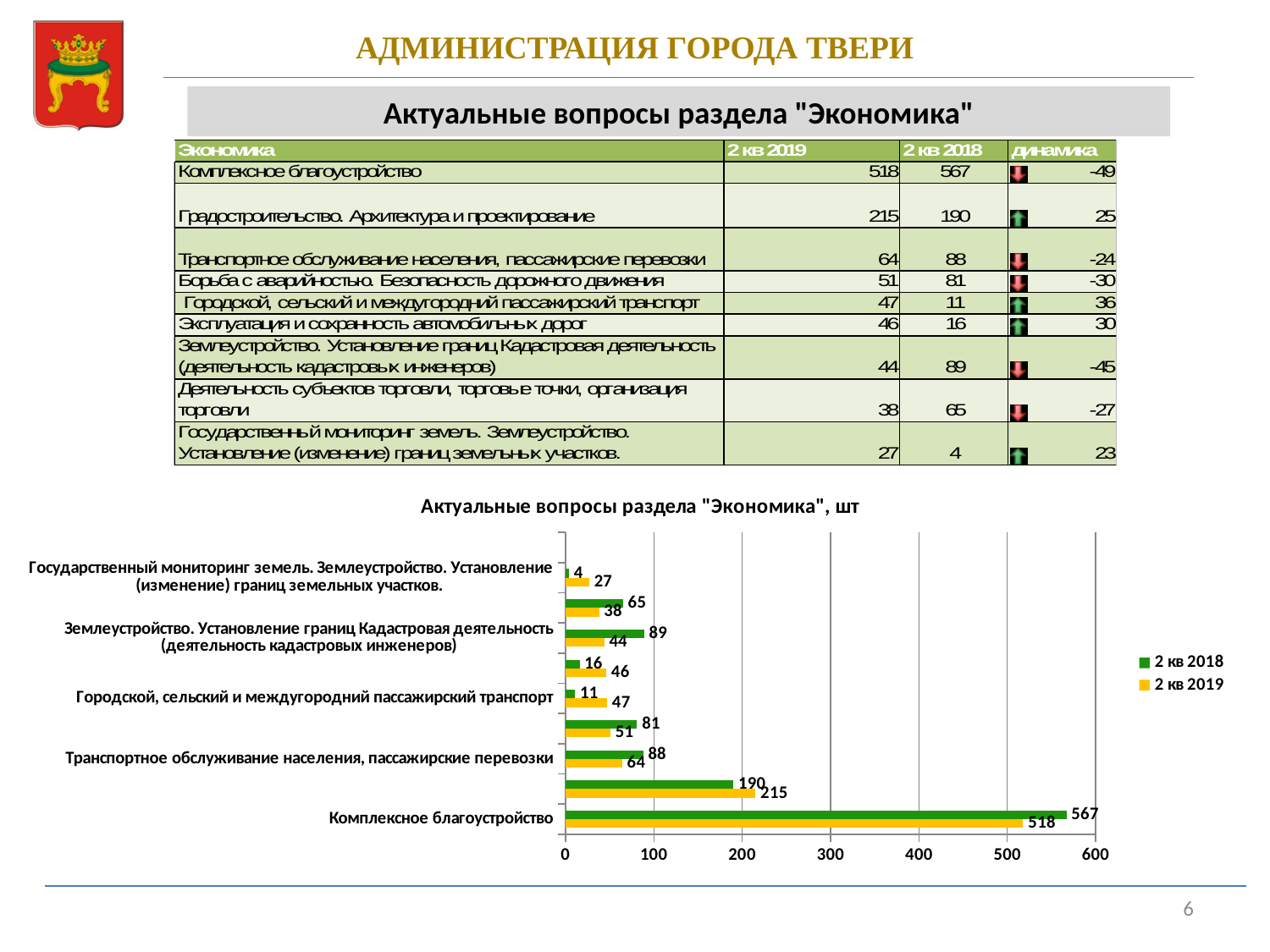
What are the two series named in the chart legend? 2 кв 2018 and 2 кв 2019 What is the 2 кв 2019 value for Комплексное благоустройство in the chart? 518 What kind of chart is shown on the slide? bar chart What is the 2 кв 2018 value for Государственный мониторинг земель. Землеустройство. Установление (изменение) границ земельных участков. in the chart? 4 Is the 2 кв 2018 value for Комплексное благоустройство greater or less than 500? greater Which category has the lowest 2 кв 2018 value in the chart? Государственный мониторинг земель. Землеустройство. Установление (изменение) границ земельных участков. What is the 2 кв 2019 value for Землеустройство. Установление границ Кадастровая деятельность (деятельность кадастровых инженеров) in the chart? 44 What is the difference between the 2 кв 2018 and 2 кв 2019 values for Комплексное благоустройство? 49 How many series does the chart legend list? 2 For Городской, сельский и междугородний пассажирский транспорт, which series has the larger value, 2 кв 2018 or 2 кв 2019? 2 кв 2019 Which category has the highest 2 кв 2018 value in the chart? Комплексное благоустройство What is the difference between the 2 кв 2018 and 2 кв 2019 values for Транспортное обслуживание населения, пассажирские перевозки? 24